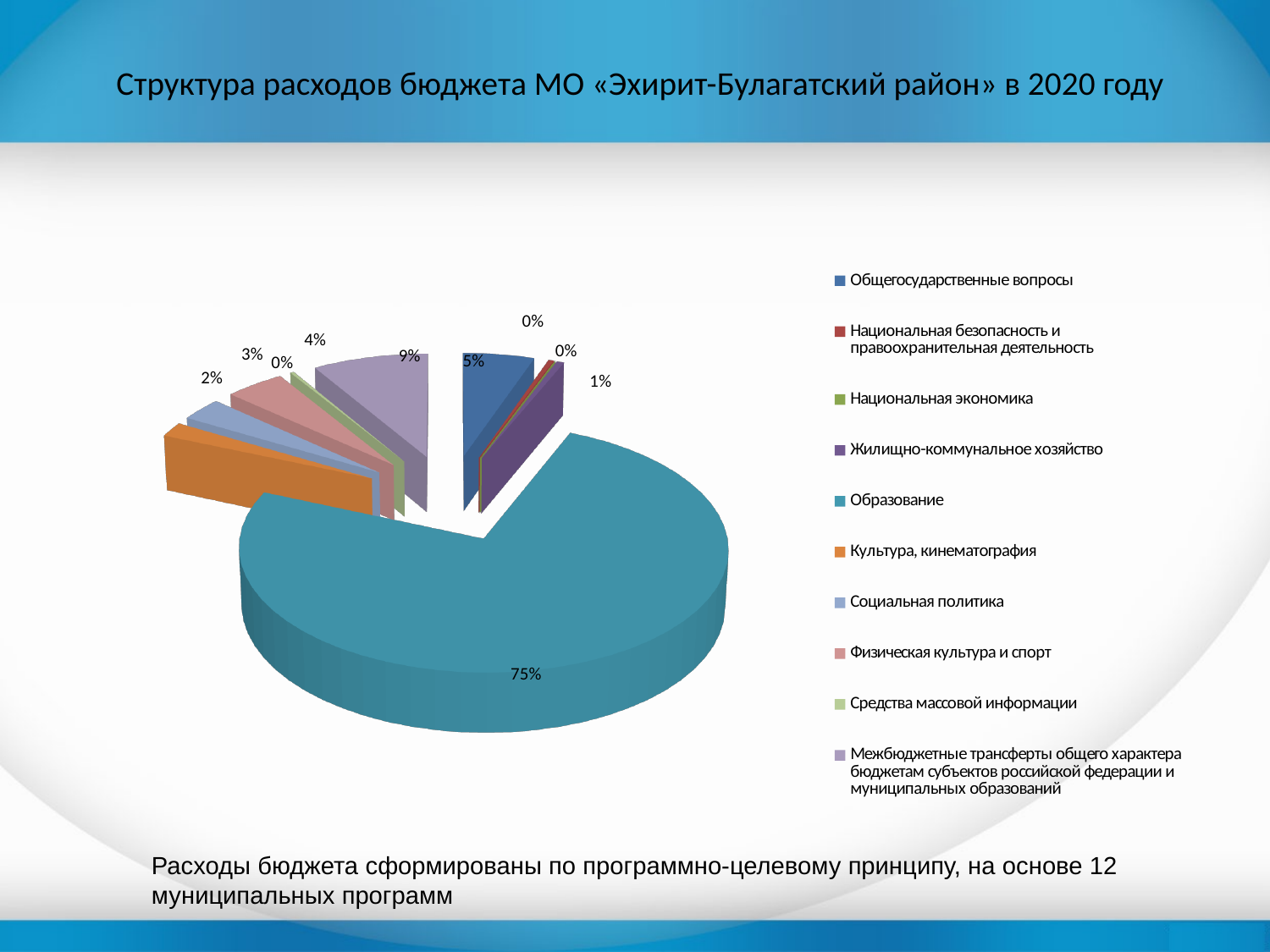
What kind of chart is shown on the slide? pie chart Which is larger: the share for Общегосударственные вопросы or the share for Жилищно-коммунальное хозяйство? Общегосударственные вопросы What is the title of the slide containing the chart? Структура расходов бюджета МО «Эхирит-Булагатский район» в 2020 году What share of the pie is labelled for Культура, кинематография? 2% What share of the pie is labelled for Жилищно-коммунальное хозяйство? 1% What share of the budget expenditure goes to Образование? 75% What colour is the slice for Образование? teal What share of the pie is labelled for Общегосударственные вопросы? 5% By how many percentage points does the share for Образование exceed the share for Культура, кинематография? 73 How many categories does the legend list? 10 Which category has the largest share of the pie? Образование Which is larger: the share for Образование or the share for Культура, кинематография? Образование